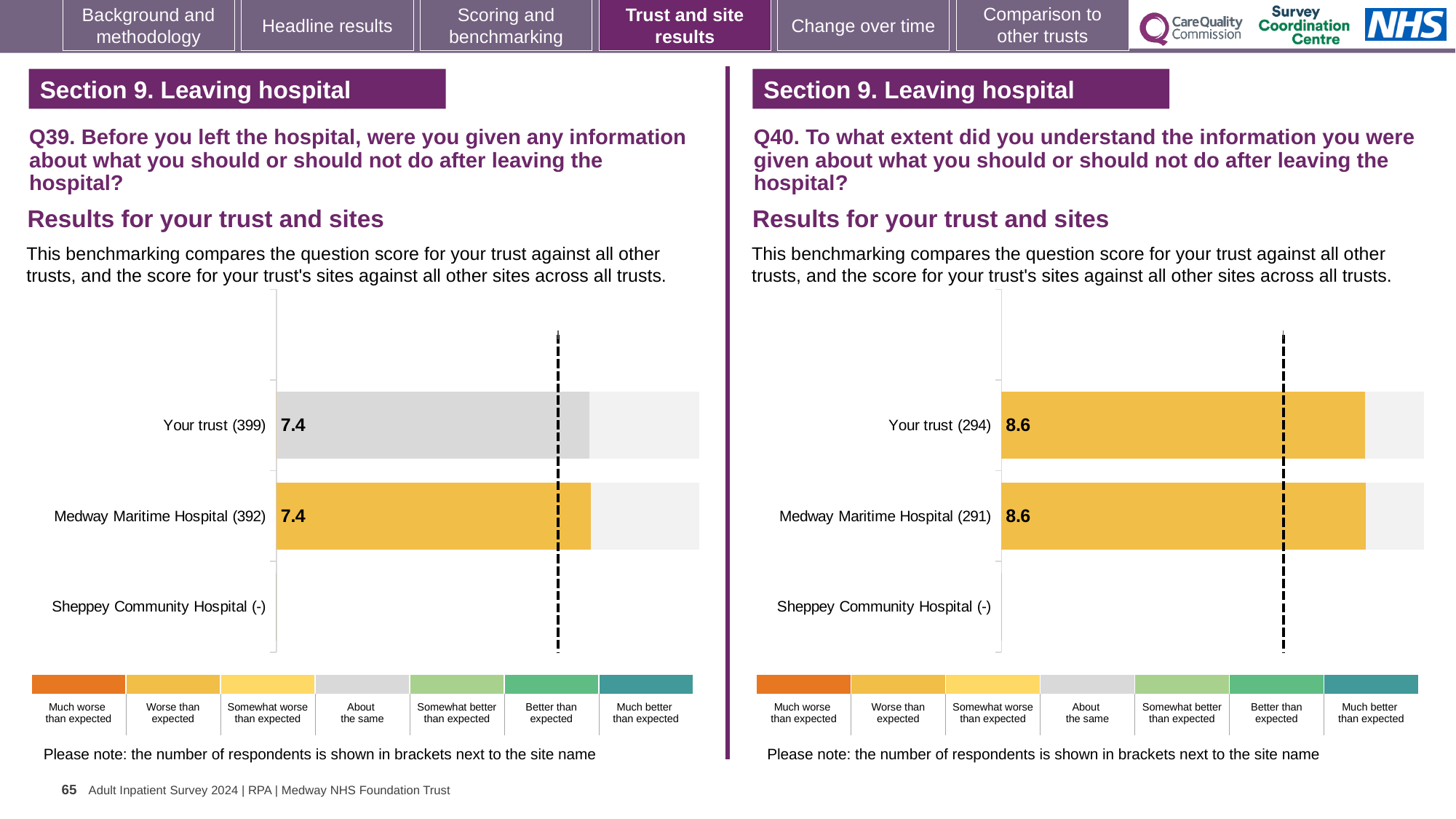
In the Q39 chart on the left, which benchmark category does the colour of the Your trust bar correspond to according to the legend? About the same In the Q39 chart on the left, how many respondents are shown in brackets for Your trust? 399 How many categories (rows) are listed on the y axis of the Q40 chart on the right? 3 In the Q40 chart on the right, which benchmark category does the colour of the Medway Maritime Hospital bar correspond to according to the legend? Worse than expected In the Q39 chart on the left, what is the difference between the score for Your trust and the score for Medway Maritime Hospital? 0.0 In the Q40 chart on the right, what is the score for Your trust? 8.6 In the Q39 chart on the left, what is the score for Medway Maritime Hospital? 7.4 In the Q40 chart on the right, what is the score for Medway Maritime Hospital? 8.6 What kind of chart is used in the Q39 chart on the left? Bar chart In the Q40 chart on the right, how many respondents are shown in brackets for Medway Maritime Hospital? 291 In the Q39 chart on the left, what is the score for Your trust? 7.4 In the Q40 chart on the right, which site has no score shown? Sheppey Community Hospital